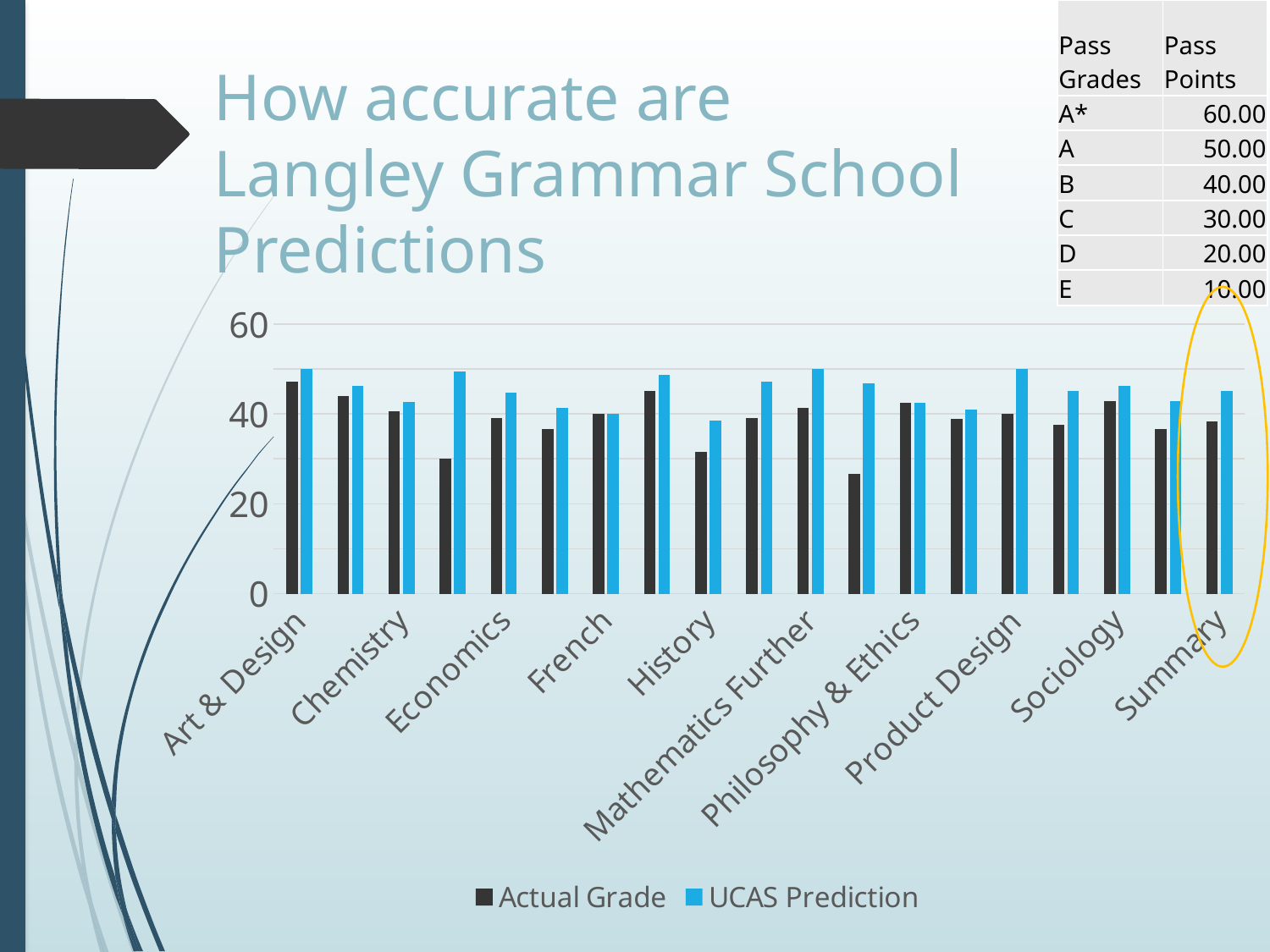
Is the Actual Grade value for History greater or less than 40? less For Product Design, which is larger: the Actual Grade or the UCAS Prediction? UCAS Prediction Among the labelled subjects, which has the lowest UCAS Prediction value? History Among the labelled subjects, which has the lowest Actual Grade value? History Which series is drawn in blue in the chart? UCAS Prediction For Mathematics Further, which is larger: the Actual Grade or the UCAS Prediction? UCAS Prediction Is the Actual Grade value for Summary greater or less than 40? less Is the Actual Grade value for Art & Design greater or less than 40? greater How many series does the chart legend list? 2 What kind of chart is shown on the slide? Bar chart What are the two series named in the chart legend? Actual Grade and UCAS Prediction